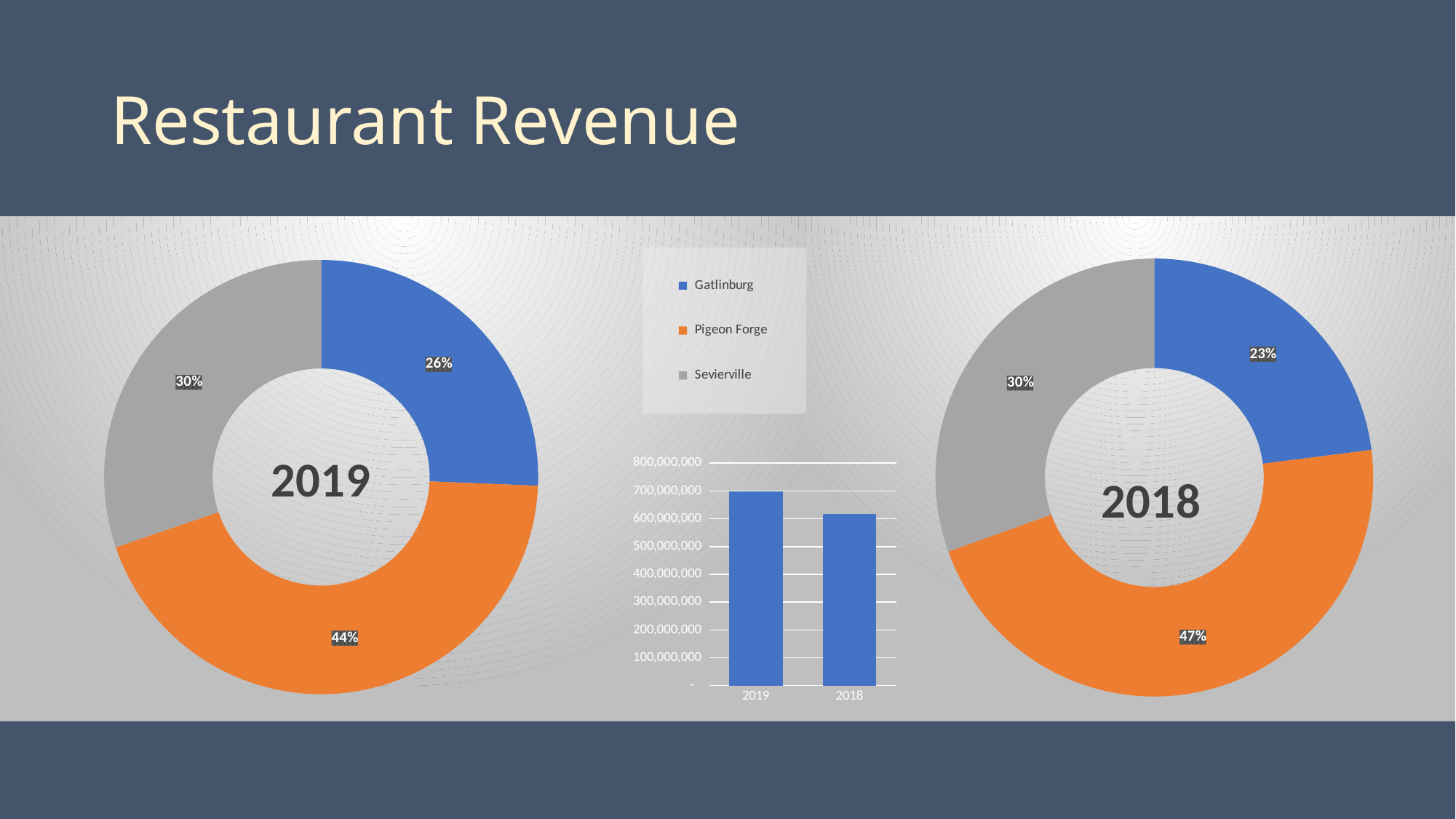
In the 2018 doughnut chart, which location has the smallest share of revenue? Gatlinburg In the 2018 doughnut chart, what percentage is shown for Sevierville? 30% In the bar chart in the middle of the slide, is the value for 2019 greater or less than 600,000,000? greater How many locations are listed in the legend between the two doughnut charts? 3 In the bar chart in the middle of the slide, which year has the taller bar? 2019 In the 2019 doughnut chart, what percentage is shown for Gatlinburg? 26% In the 2019 doughnut chart, which location has the largest share of revenue? Pigeon Forge In the 2019 doughnut chart, what share of restaurant revenue does Pigeon Forge have? 44% In the 2018 doughnut chart, what share does Gatlinburg have? 23% Comparing the two doughnut charts, in which year was Gatlinburg's share larger, 2019 or 2018? 2019 In the 2018 doughnut chart, what percentage is shown for Pigeon Forge? 47% By how many percentage points did Pigeon Forge's share change between the 2018 and 2019 doughnut charts? 3 percentage points